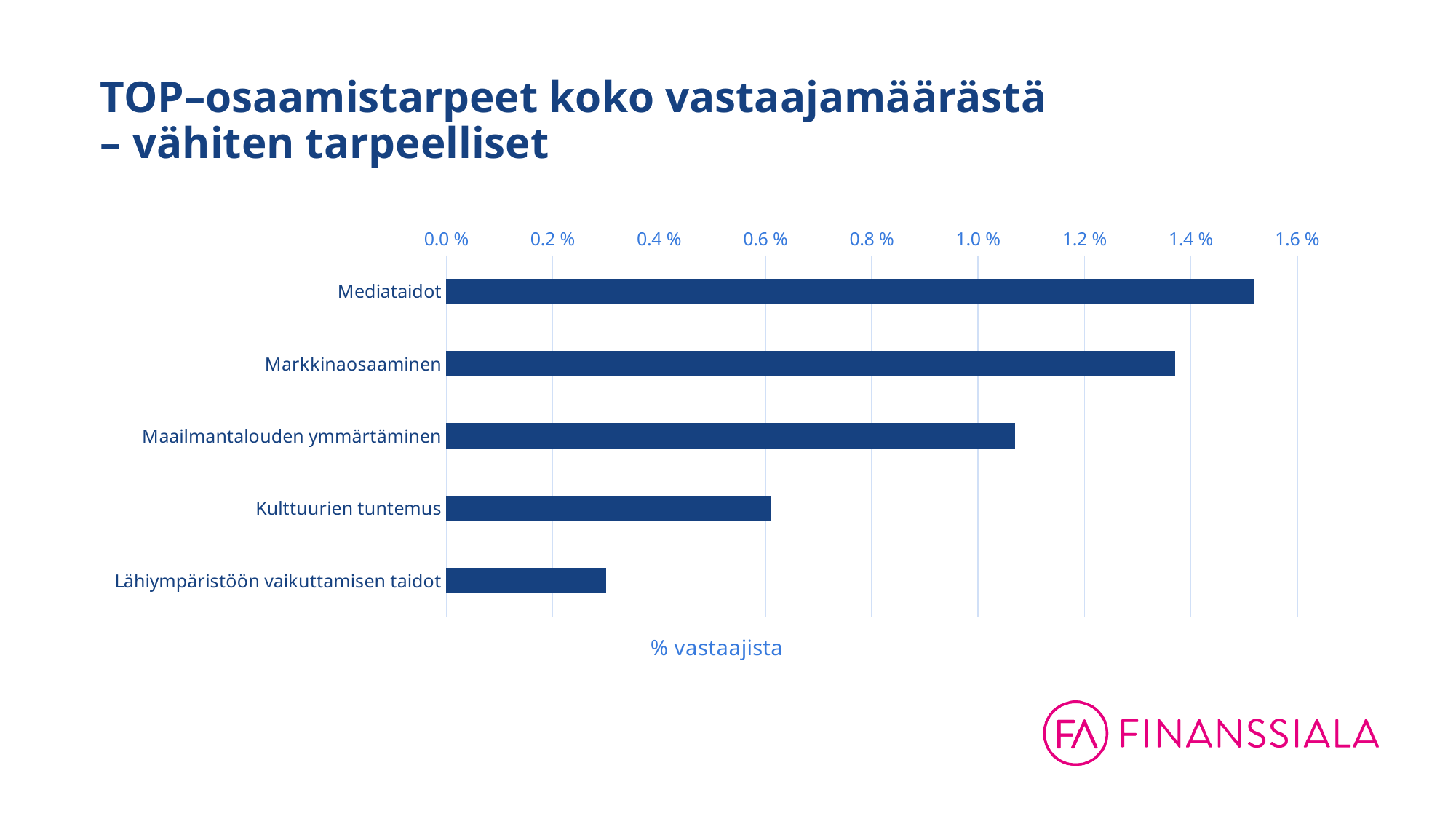
What kind of chart is shown on the slide? bar chart Is the value for Lähiympäristöön vaikuttamisen taidot greater or less than 0.4 %? less Is the value for Mediataidot greater or less than 1.4 %? greater What is the title of the slide? TOP–osaamistarpeet koko vastaajamäärästä – vähiten tarpeelliset Is the value for Maailmantalouden ymmärtäminen greater or less than 0.8 %? greater Which category has the lowest value in the chart? Lähiympäristöön vaikuttamisen taidot What is the label of the horizontal axis of the chart? % vastaajista How many categories are plotted in the chart? 5 Which is larger, the value for Kulttuurien tuntemus or the value for Maailmantalouden ymmärtäminen? Maailmantalouden ymmärtäminen Which category has the highest value in the chart? Mediataidot